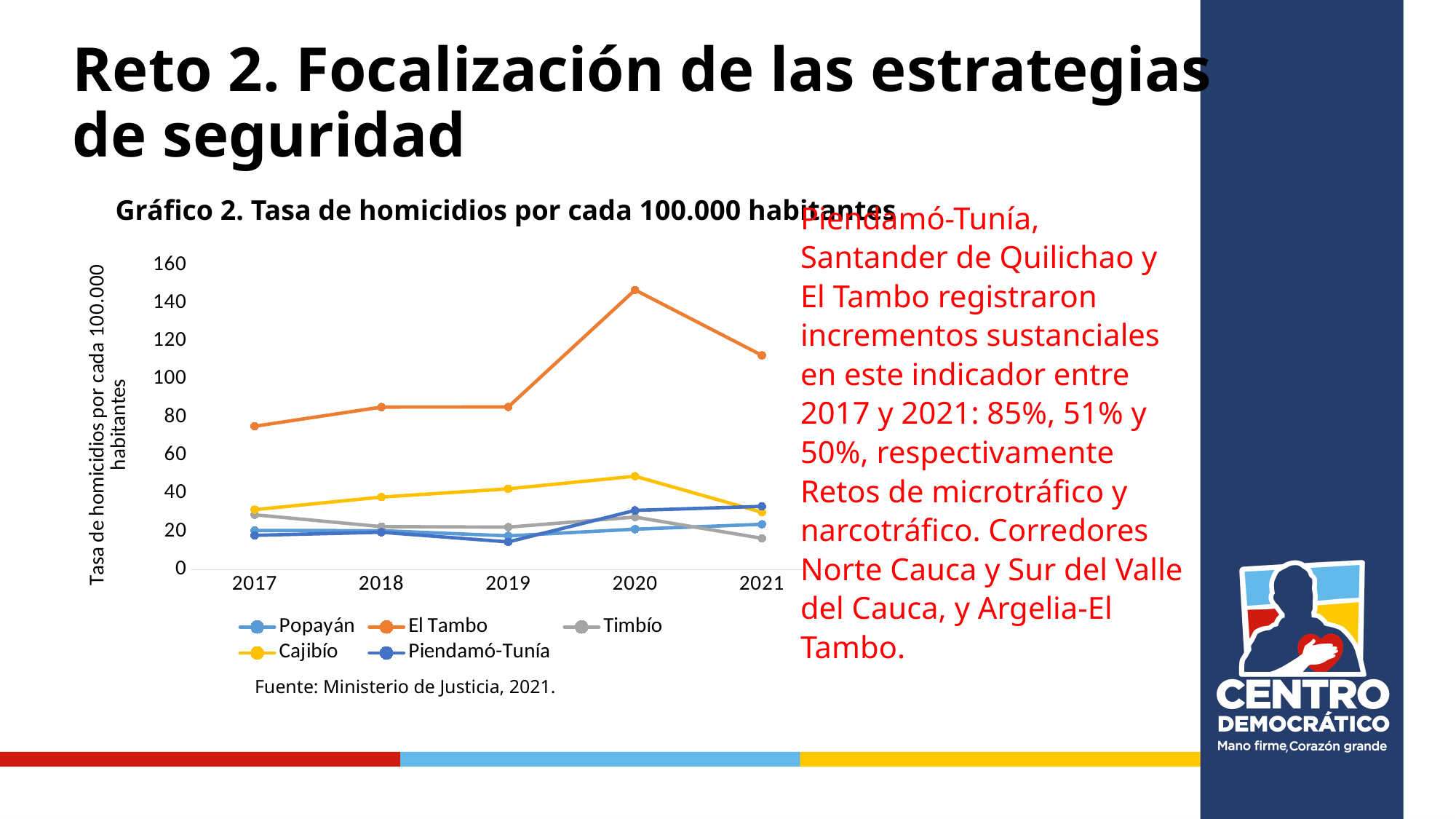
Is the value for Cajibío in 2020 greater or less than 40? greater Which municipality has the highest homicide rate in 2017? El Tambo Does the homicide rate for El Tambo rise or fall between 2019 and 2020? rise Is the value for El Tambo in 2020 greater or less than 140? greater How many years are shown on the x axis of Gráfico 2? 5 What kind of chart is Gráfico 2? line chart Which municipality has the highest homicide rate in 2020? El Tambo Which is larger in 2019, the value for Cajibío or the value for Timbío? Cajibío Is the value for El Tambo in 2021 greater or less than 100? greater How many series does the legend of Gráfico 2 list? 5 What is the label of the y axis in Gráfico 2? Tasa de homicidios por cada 100.000 habitantes